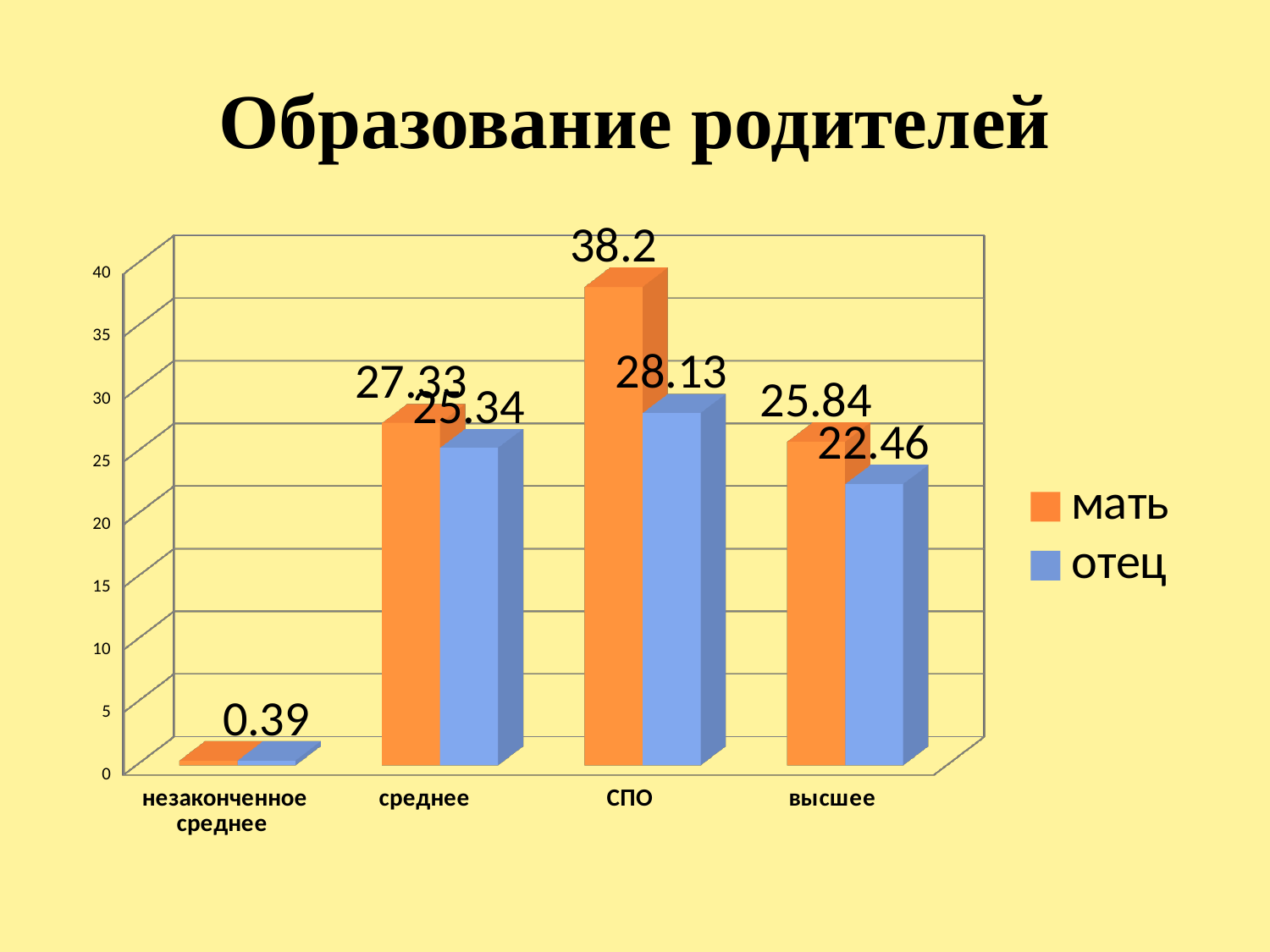
What is the value for мать in the высшее category? 25.84 What is the value for мать in the СПО category? 38.2 What is the value for отец in the высшее category? 22.46 Which category has the lowest value for мать? незаконченное среднее How many series does the legend list? 2 What kind of chart is shown on the slide? bar chart Which category has the highest value for мать? СПО How many education categories are shown on the x axis? 4 What is the value for отец in the среднее category? 25.34 What is the difference between the мать and отец values in the СПО category? 10.07 In the среднее category, which series has the larger value, мать or отец? мать What is the difference between the мать and отец values in the высшее category? 3.38